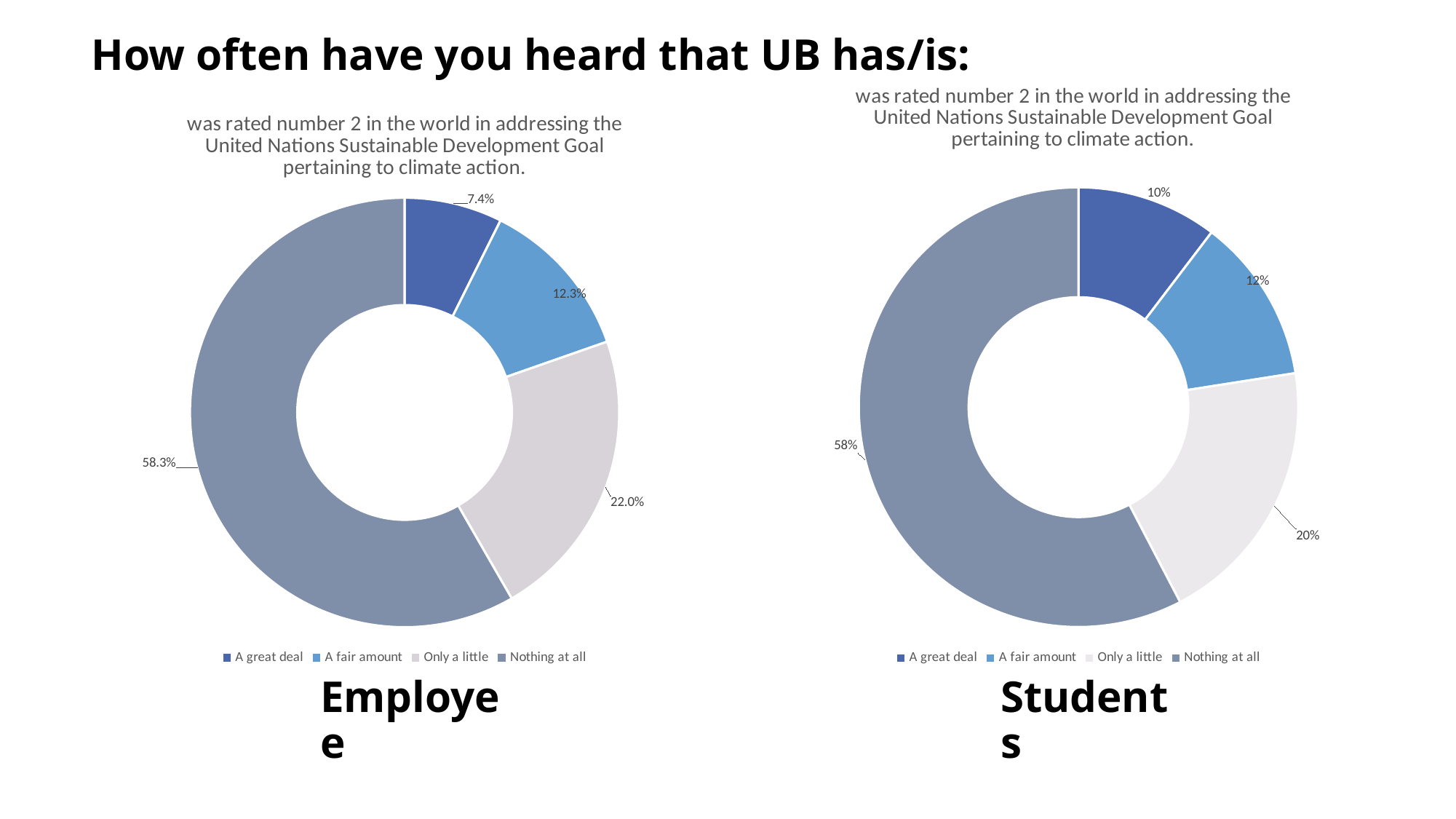
In the Students chart, what colour is the 'Nothing at all' segment? Grey-blue What type of chart is used for the Students data? Doughnut chart In the Employee chart, what is the difference between the 'Only a little' and 'A fair amount' shares? 9.7% Which is larger: the 'A great deal' share in the Employee chart or the 'A great deal' share in the Students chart? Students In the Students chart, what percentage of respondents answered 'A fair amount'? 12% In the Students chart, what is the difference between the 'Nothing at all' and 'Only a little' shares? 38% In the Employee chart, what percentage of respondents answered 'Nothing at all'? 58.3% In the Employee chart, what percentage of respondents answered 'A great deal'? 7.4% In the Students chart, what percentage of respondents answered 'Only a little'? 20% In the Employee chart, which response category has the largest share? Nothing at all In the Students chart, which response category has the smallest share? A great deal How many response categories does the legend of the Employee chart list? 4